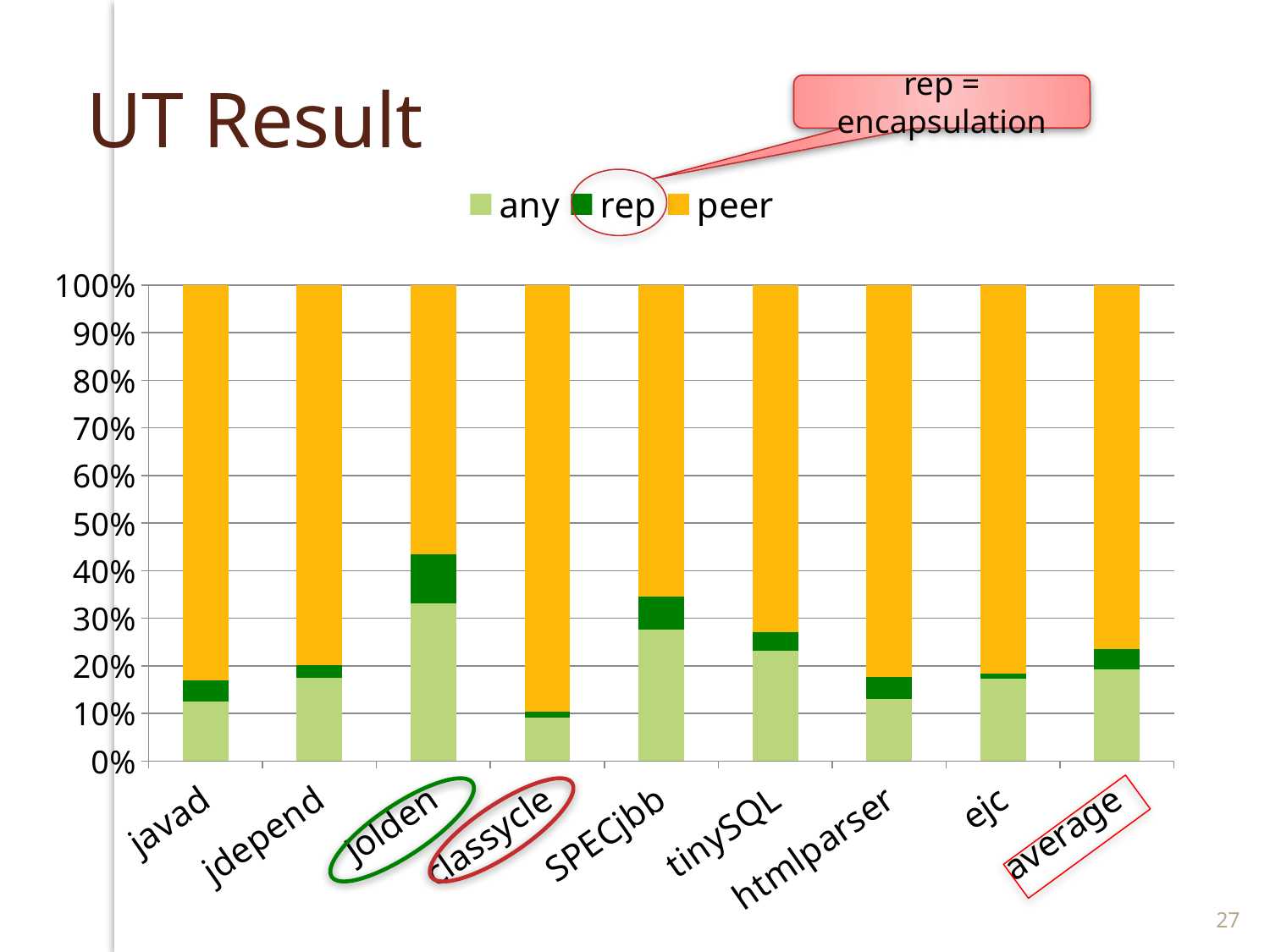
Which category has the largest 'peer' segment? classycle Which category has the smallest 'any' segment? classycle Which category has the largest 'any' segment? Jolden According to the callout on the slide, what does 'rep' stand for? encapsulation Is the 'any' value for Jolden greater or less than 30%? greater What kind of chart is shown on the slide? stacked bar chart What is the total height of the stacked bar for javad? 100% Is the 'any' value for javad greater or less than 20%? less How many categories are shown on the x axis of the chart? 9 Is the 'any' value for SPECjbb greater or less than 20%? greater Which has a larger 'any' segment, Jolden or SPECjbb? Jolden How many series does the chart legend list? 3